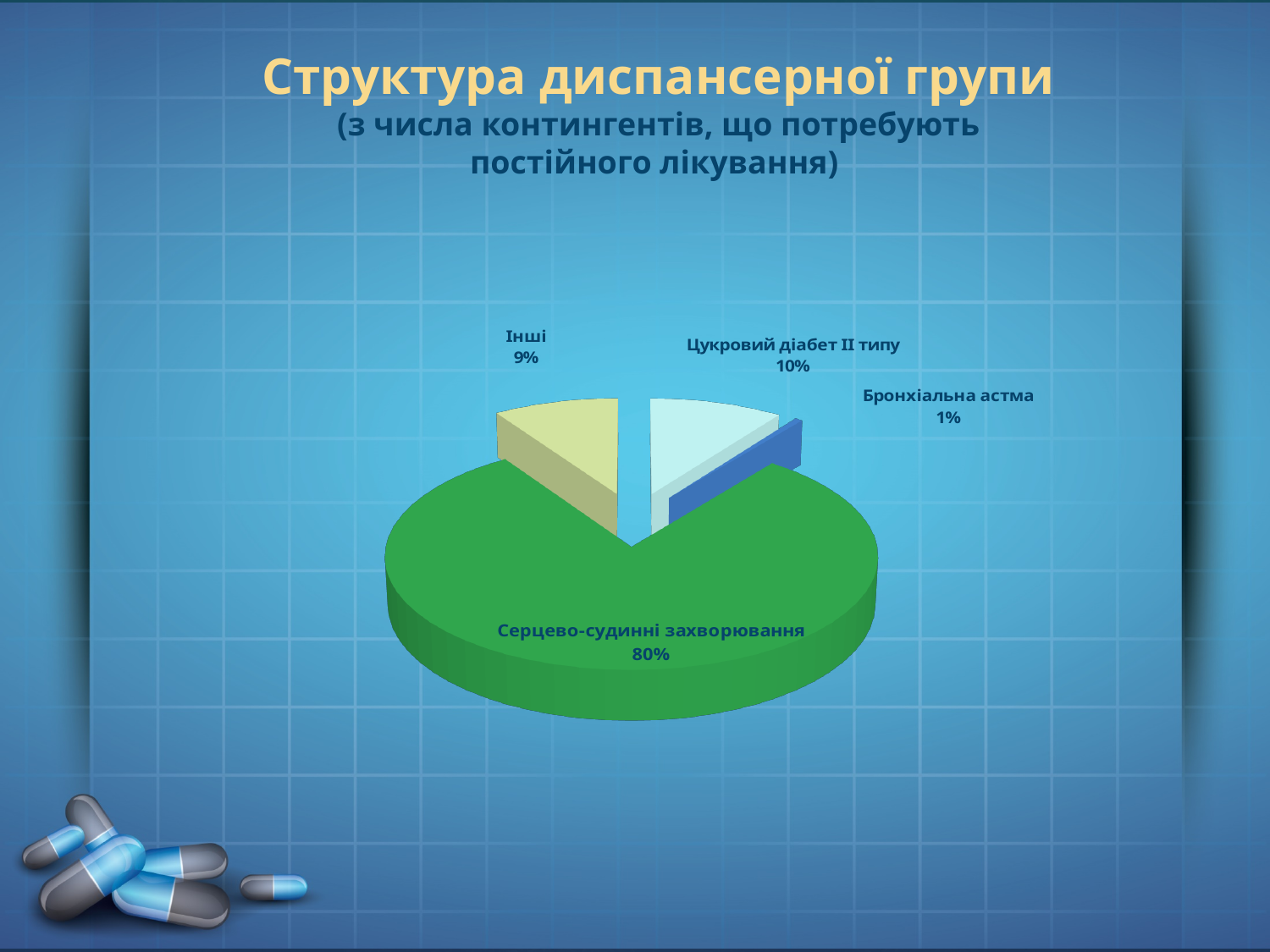
What share of the pie does Цукровий діабет II типу have? 10% Which category has the largest slice of the pie? Серцево-судинні захворювання What is the difference in percentage points between Інші and Бронхіальна астма? 8 How many slices does the pie chart have? 4 Which category has the smallest slice of the pie? Бронхіальна астма What share of the pie does Бронхіальна астма have? 1% What kind of chart is shown on the slide? pie chart What colour is the slice for Серцево-судинні захворювання? green What share of the pie does Інші have? 9% Which is larger, the share for Цукровий діабет II типу or the share for Інші? Цукровий діабет II типу What is the difference in percentage points between Серцево-судинні захворювання and Цукровий діабет II типу? 70